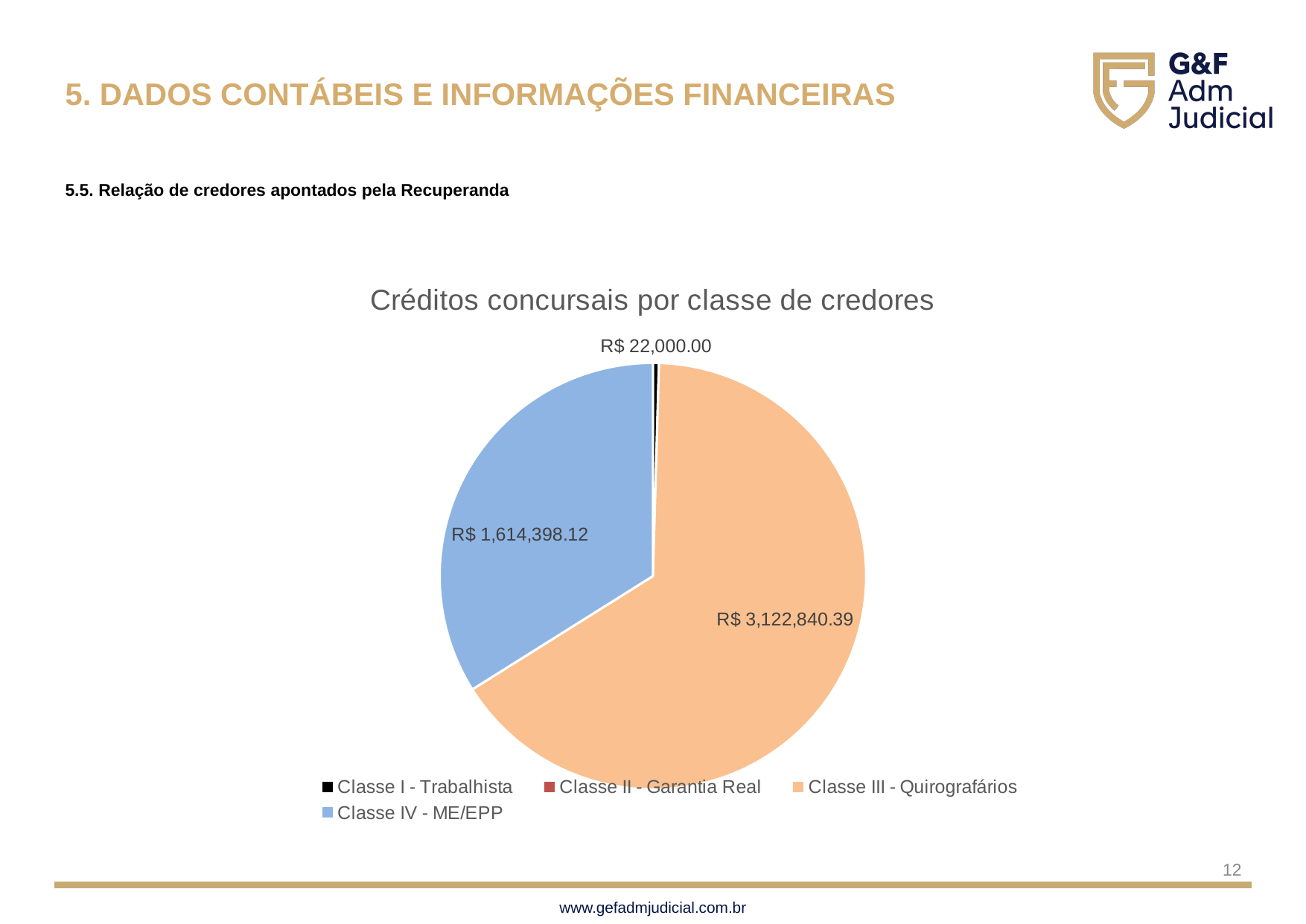
Which class of creditors has the largest slice of the pie? Classe III - Quirografários Which of the labeled slices is the smallest? Classe I - Trabalhista What is the value shown for Classe I - Trabalhista? R$ 22,000.00 Which is larger, the value for Classe III - Quirografários or the value for Classe IV - ME/EPP? Classe III - Quirografários What is the value shown for Classe IV - ME/EPP? R$ 1,614,398.12 What is the value shown for Classe III - Quirografários? R$ 3,122,840.39 What kind of chart is shown on the slide? pie chart How many data labels with values are printed on the pie chart? 3 Which colour represents Classe IV - ME/EPP in the chart? blue What is the title of the chart? Créditos concursais por classe de credores What is the difference between the value for Classe III - Quirografários and the value for Classe IV - ME/EPP? R$ 1,508,442.27 How many classes of creditors does the legend list? 4